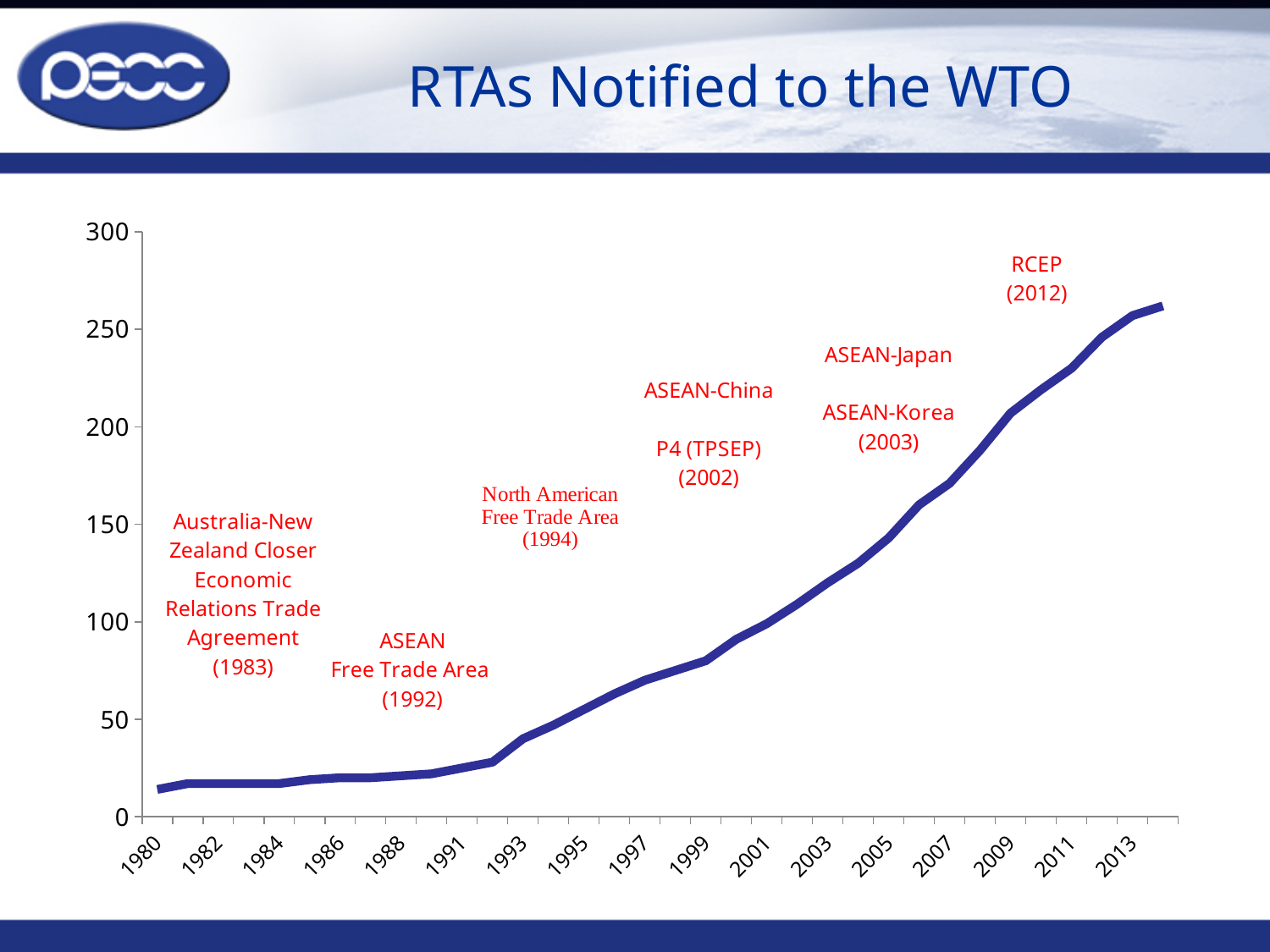
How many year labels are shown on the x axis? 17 What kind of chart is shown on the slide? line chart Which agreement is annotated on the chart with the year 2012? RCEP Is the value for 2007 greater or less than 150? greater Is the value for 1993 greater or less than 50? less Is the value for 2011 greater or less than 200? greater Do the values rise or fall along the x axis from 1980 to 2013? rise Which year labelled on the x axis has the lowest value? 1980 What is the title of the slide's chart? RTAs Notified to the WTO